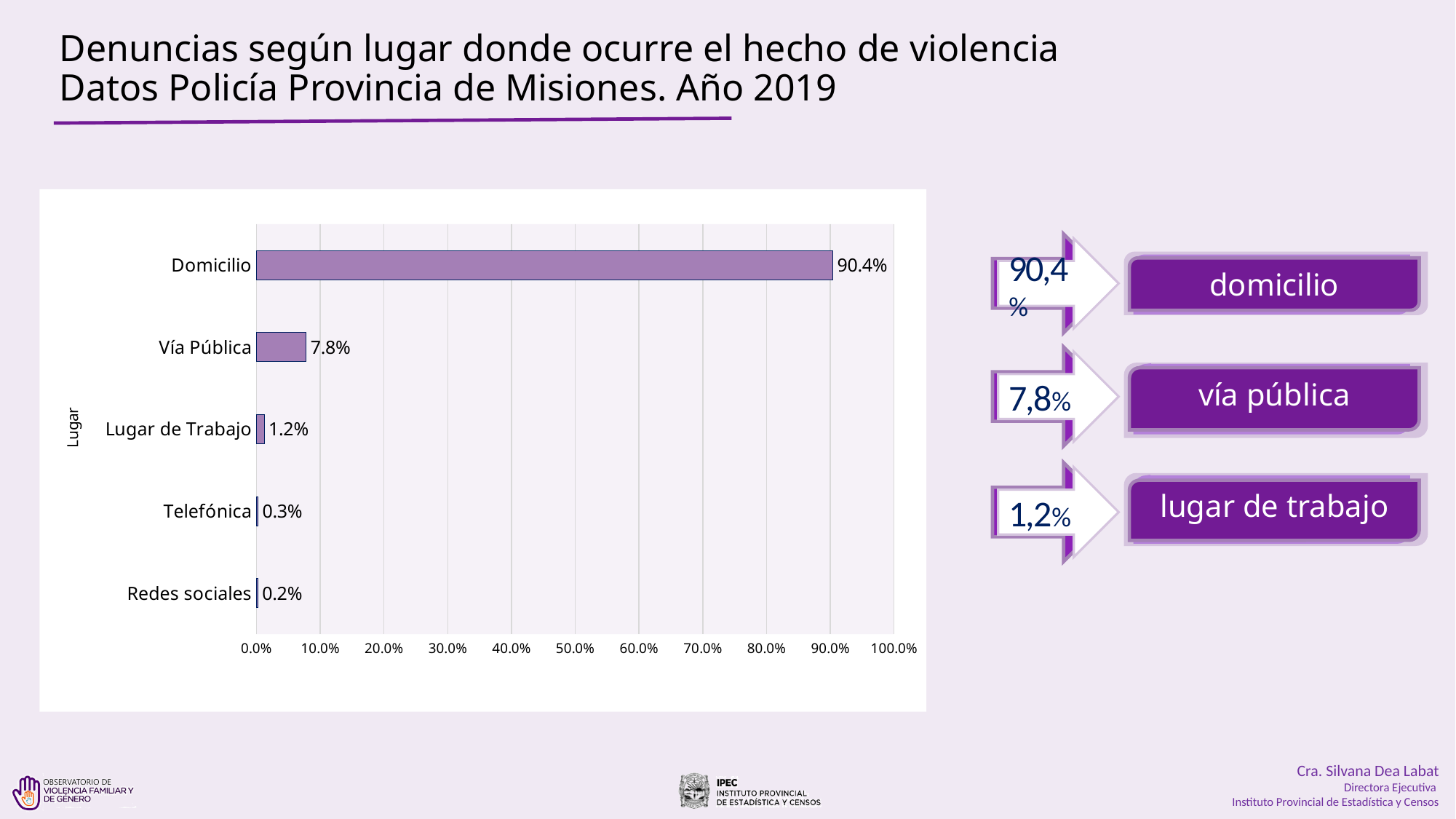
What kind of chart is shown on the slide? Bar chart How many categories are shown in the chart? 5 Which category has the lowest value? Redes sociales What is the difference between the values for Domicilio and Vía Pública? 82.6% What is the value for Lugar de Trabajo? 1.2% Which is larger, the value for Vía Pública or the value for Lugar de Trabajo? Vía Pública What is the value for Domicilio? 90.4% Which category has the highest value? Domicilio What is the value for Telefónica? 0.3% What is the value for Vía Pública? 7.8% What is the value for Redes sociales? 0.2% What is the label of the vertical axis of the chart? Lugar